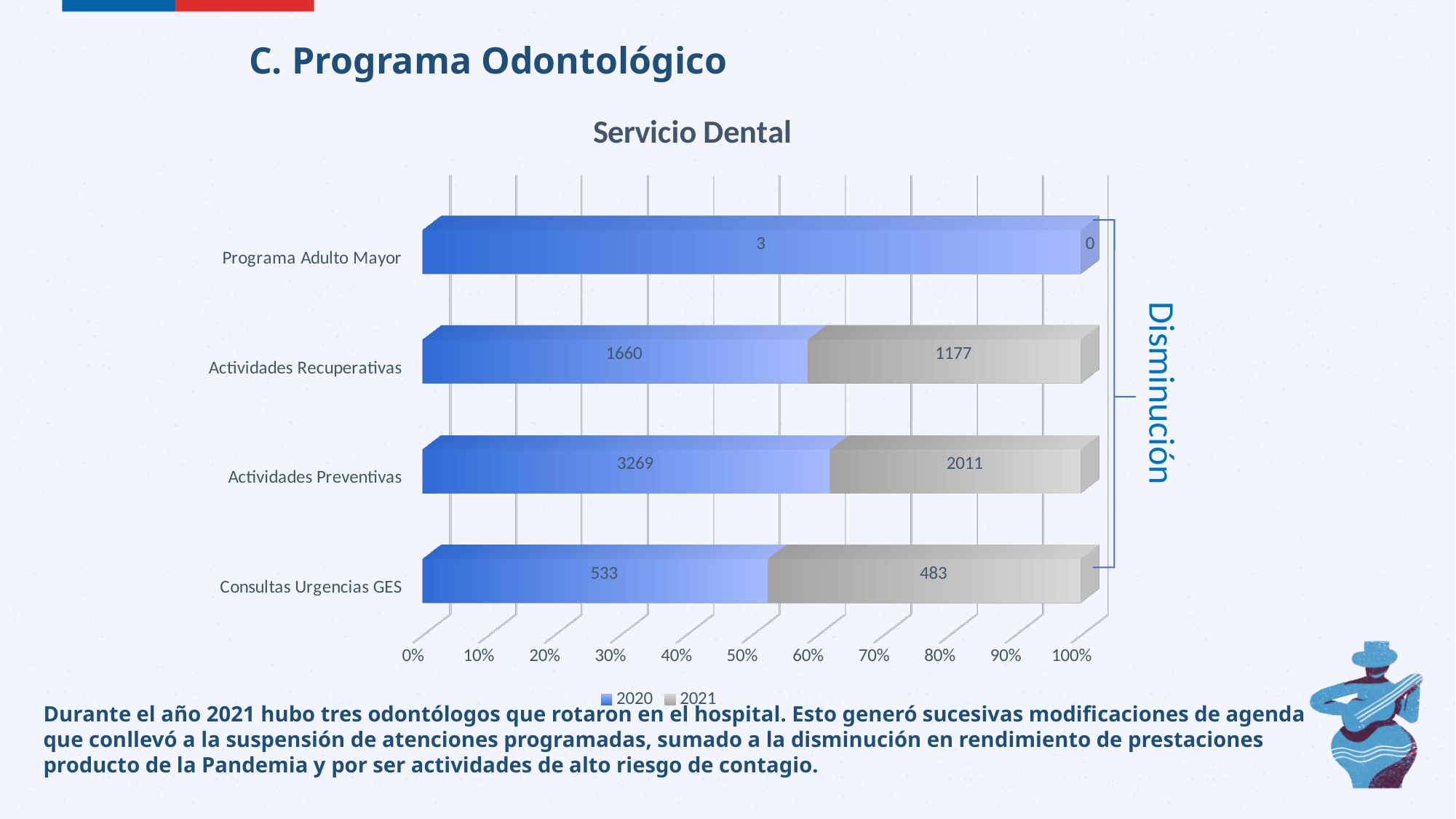
Which category has the highest 2020 value? Actividades Preventivas Which category has the lowest 2021 value? Programa Adulto Mayor What is the 2021 value for Programa Adulto Mayor? 0 What kind of chart is shown on the slide? Bar chart What is the 2020 value for Consultas Urgencias GES? 533 Which is larger for Actividades Recuperativas, the 2020 value or the 2021 value? 2020 What is the difference between the 2020 and 2021 values for Actividades Preventivas? 1258 What is the title of the chart? Servicio Dental How many categories are shown on the chart? 4 How many series does the legend list? 2 What is the 2020 value for Actividades Preventivas? 3269 What is the 2021 value for Actividades Recuperativas? 1177